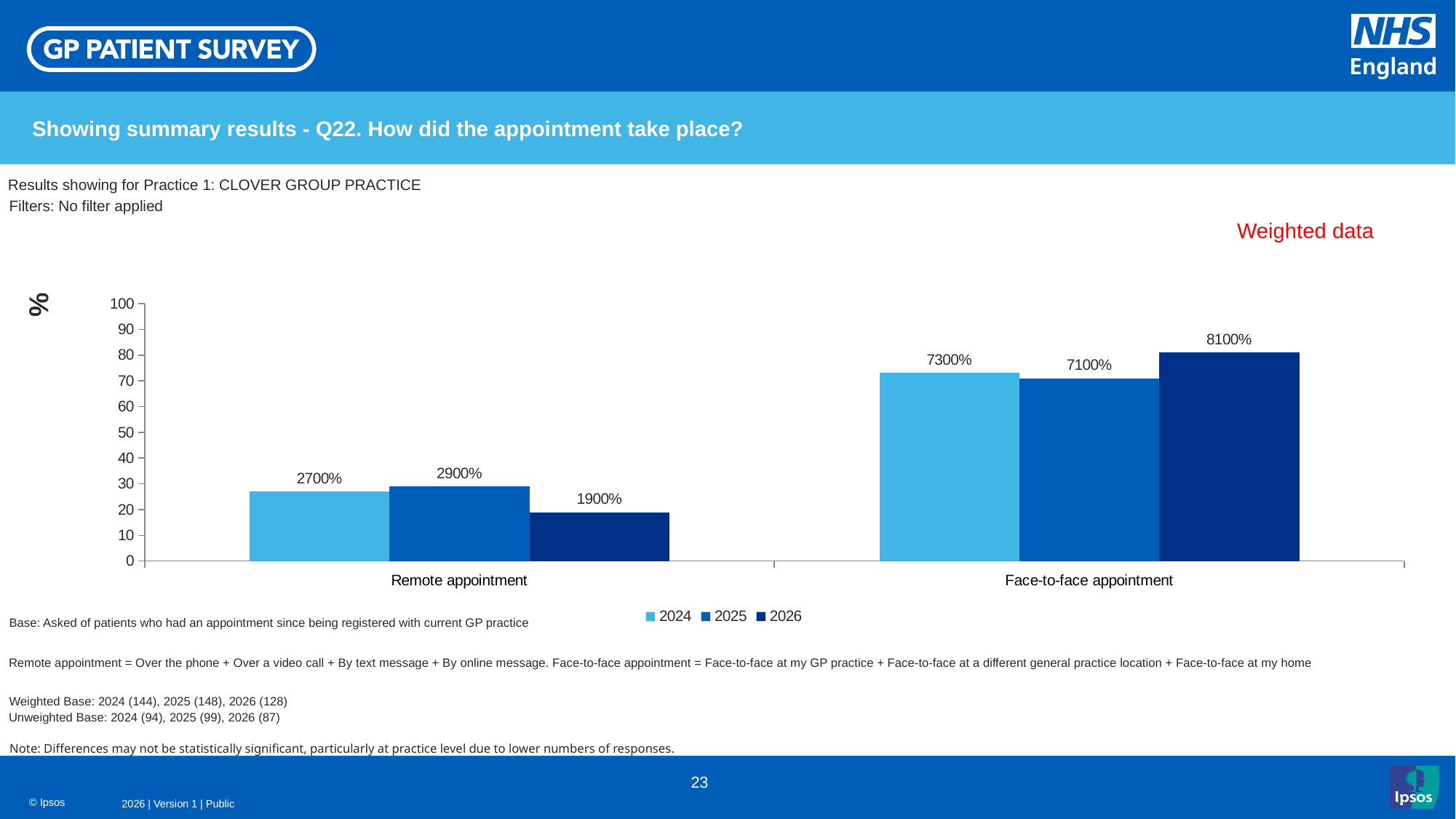
What is the value for Remote appointment in 2026? 1900% What kind of chart is shown on the slide? Bar chart What are the entries in the chart legend? 2024, 2025, 2026 What is the value for Face-to-face appointment in 2025? 7100% What is the value for Face-to-face appointment in 2026? 8100% Which year has the lowest value for Remote appointment? 2026 What is the value for Remote appointment in 2024? 2700% How many series does the legend list? 3 What is the difference between the 2025 and 2024 values for Remote appointment? 200% Which year has the highest value for Face-to-face appointment? 2026 How many categories are shown on the x axis? 2 Which is larger: the 2024 value for Face-to-face appointment or the 2025 value for Face-to-face appointment? 2024